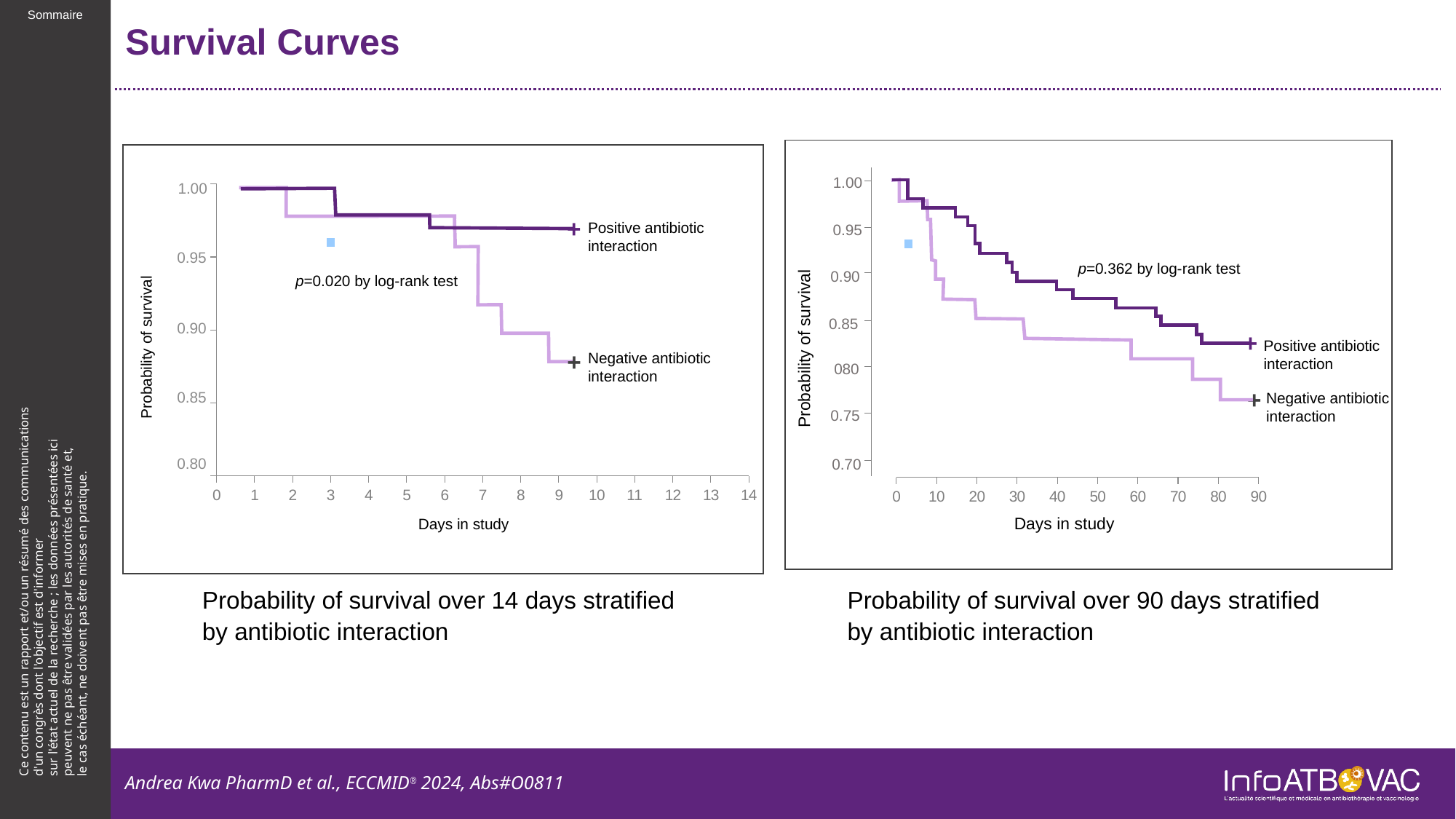
What p-value by log-rank test is shown on the right chart (90 days)? p=0.362 What is the x-axis label of the right chart (90 days)? Days in study In the right chart (90 days), do the survival curves rise or fall as days in study increase? Fall In the right chart (90 days), which group has the lower probability of survival at day 90, positive or negative antibiotic interaction? Negative antibiotic interaction In the left chart (14 days), which group has the higher probability of survival at the end of follow-up, positive or negative antibiotic interaction? Positive antibiotic interaction In the right chart (90 days), is the final probability of survival for the negative antibiotic interaction group greater or less than 0.80? less In the left chart (14 days), is the final probability of survival for the negative antibiotic interaction group greater or less than 0.90? less In the right chart (90 days), is the final probability of survival for the positive antibiotic interaction group greater or less than 0.80? greater How many series (curves) are shown in the left chart, 'Probability of survival over 14 days'? 2 What kind of chart is the left chart, 'Probability of survival over 14 days stratified by antibiotic interaction'? Line chart (survival curve) What p-value by log-rank test is shown on the left chart (14 days)? p=0.020